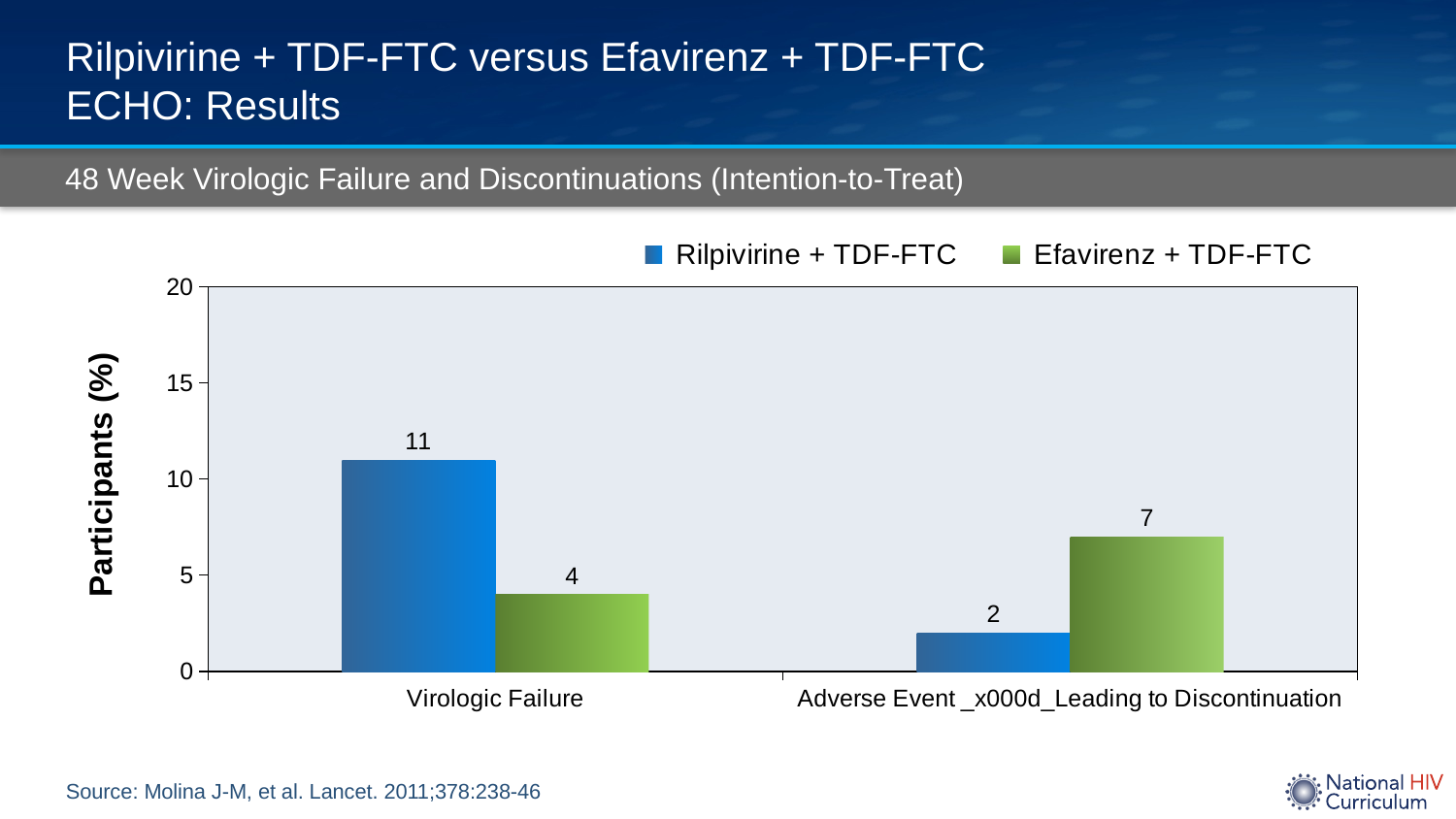
What type of chart is shown on the slide? Bar chart What percentage of participants in the Efavirenz + TDF-FTC group had virologic failure? 4 What is the difference in the rate of adverse events leading to discontinuation between the Efavirenz + TDF-FTC and Rilpivirine + TDF-FTC groups? 5 Which group had the higher rate of adverse events leading to discontinuation? Efavirenz + TDF-FTC What percentage of participants in the Rilpivirine + TDF-FTC group had virologic failure? 11 Which group had the higher rate of virologic failure? Rilpivirine + TDF-FTC What percentage of participants in the Efavirenz + TDF-FTC group had an adverse event leading to discontinuation? 7 What is the label of the y-axis? Participants (%) Which bar in the chart has the highest value? Rilpivirine + TDF-FTC, Virologic Failure What is the difference in virologic failure rate between the Rilpivirine + TDF-FTC and Efavirenz + TDF-FTC groups? 7 What percentage of participants in the Rilpivirine + TDF-FTC group had an adverse event leading to discontinuation? 2 How many series does the legend list? 2